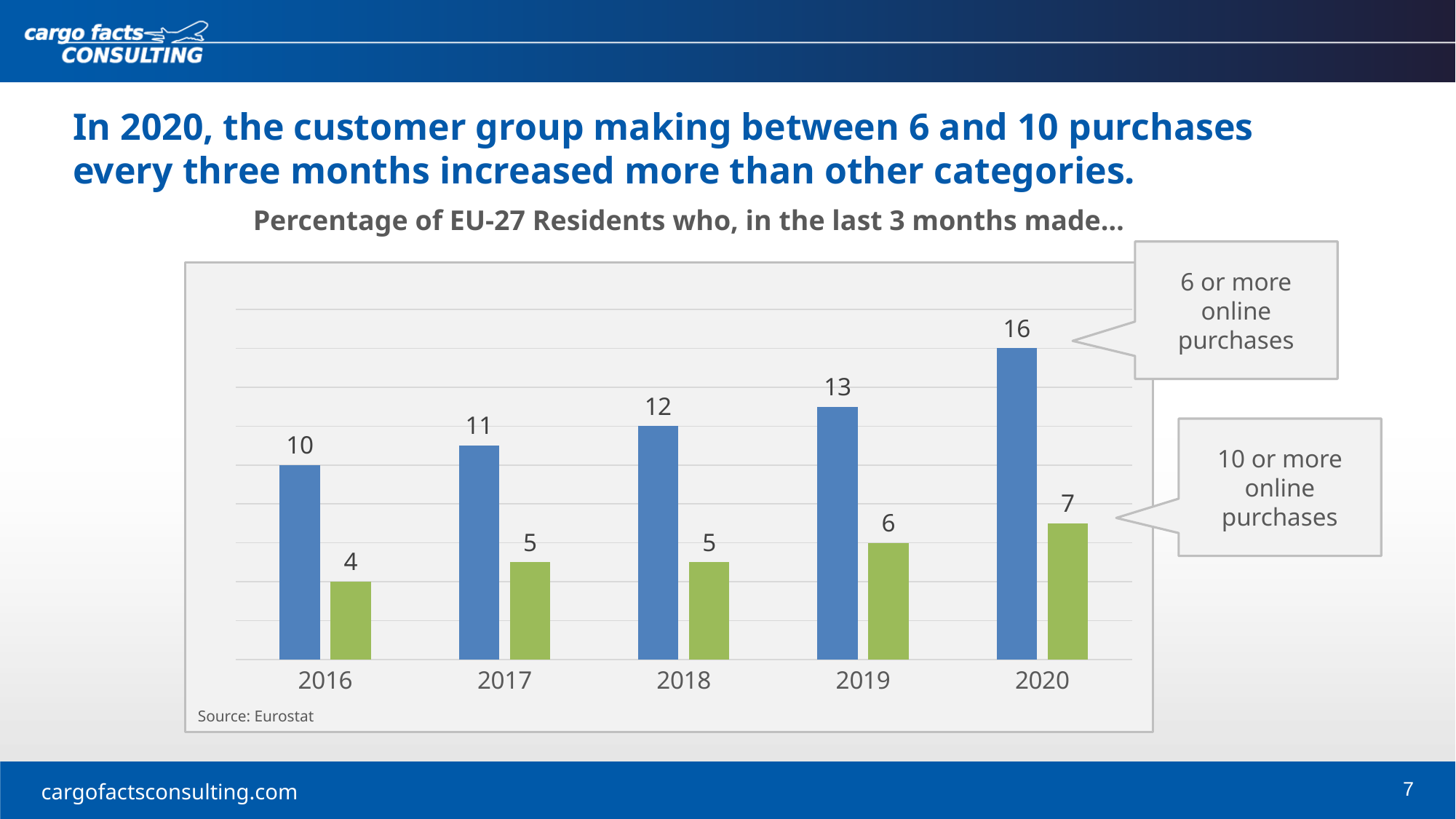
What is the value for '6 or more online purchases' in 2020? 16 In which year is the value for '10 or more online purchases' lowest? 2016 Which is larger in 2017: the value for '6 or more online purchases' or '10 or more online purchases'? 6 or more online purchases Do the values for '6 or more online purchases' rise or fall from 2016 to 2020? Rise What is the difference between the '6 or more online purchases' values for 2020 and 2016? 6 What is the value for '10 or more online purchases' in 2019? 6 What is the value for '6 or more online purchases' in 2018? 12 What kind of chart is shown on the slide? Bar chart How many years are shown on the x axis? 5 What is the value for '10 or more online purchases' in 2016? 4 In which year is the value for '6 or more online purchases' highest? 2020 How many data series does the chart show? 2